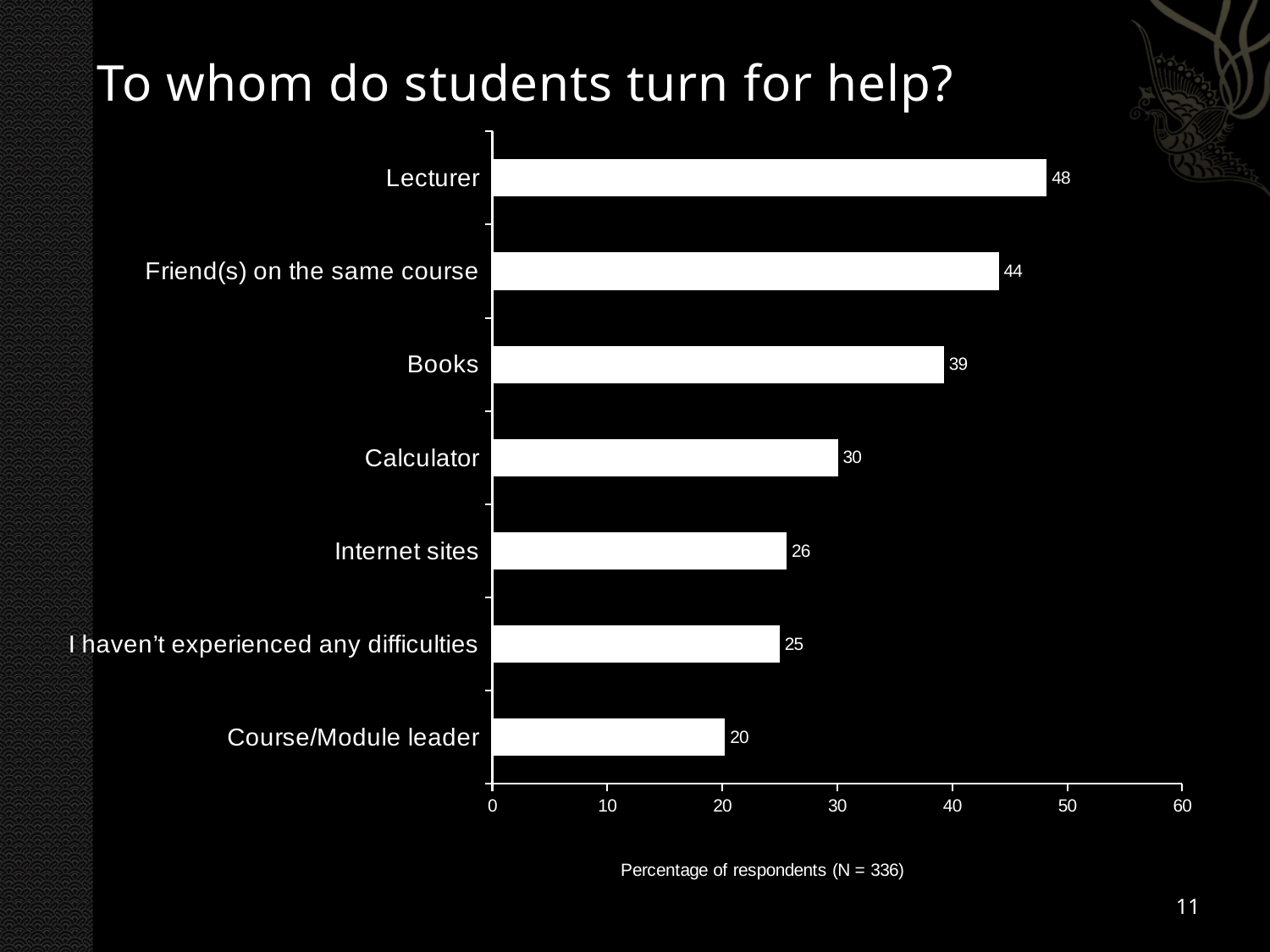
Which category has the lowest value? Course/Module leader What is the difference between the values for Lecturer and Friend(s) on the same course? 4 Which category has the highest value? Lecturer How many categories are shown in the chart? 7 What is the value for Course/Module leader? 20 Is the value for Books greater or less than 40? less Which is larger, the value for Calculator or the value for Internet sites? Calculator What is the value for Books? 39 What is the x-axis label of the chart? Percentage of respondents (N = 336) What is the difference between the values for Internet sites and I haven't experienced any difficulties? 1 What is the value for Lecturer? 48 What kind of chart is shown on the slide? bar chart